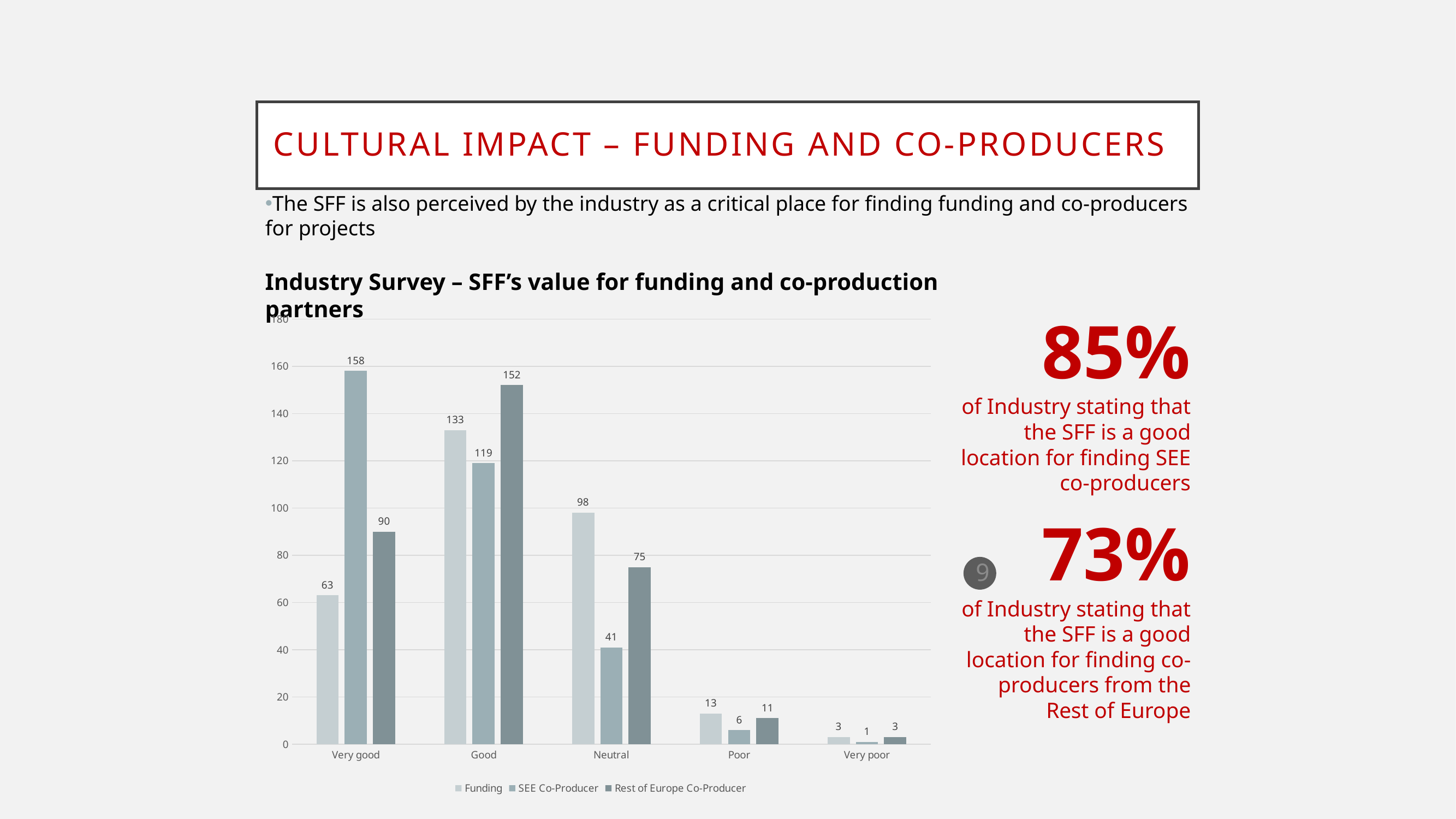
Do the Rest of Europe Co-Producer values rise or fall from Good to Very poor? Fall What is the value for SEE Co-Producer in the Very good category? 158 What is the title of the chart? Industry Survey – SFF’s value for funding and co-production partners How many series does the legend list? 3 What kind of chart is shown on the slide? Bar chart How many categories are shown on the x axis? 5 Which category has the highest Funding value? Good What is the value for Funding in the Neutral category? 98 Which is larger in the Neutral category: Funding or Rest of Europe Co-Producer? Funding What is the difference between the SEE Co-Producer and Funding values in the Very good category? 95 What is the value for Rest of Europe Co-Producer in the Good category? 152 Which category has the lowest SEE Co-Producer value? Very poor